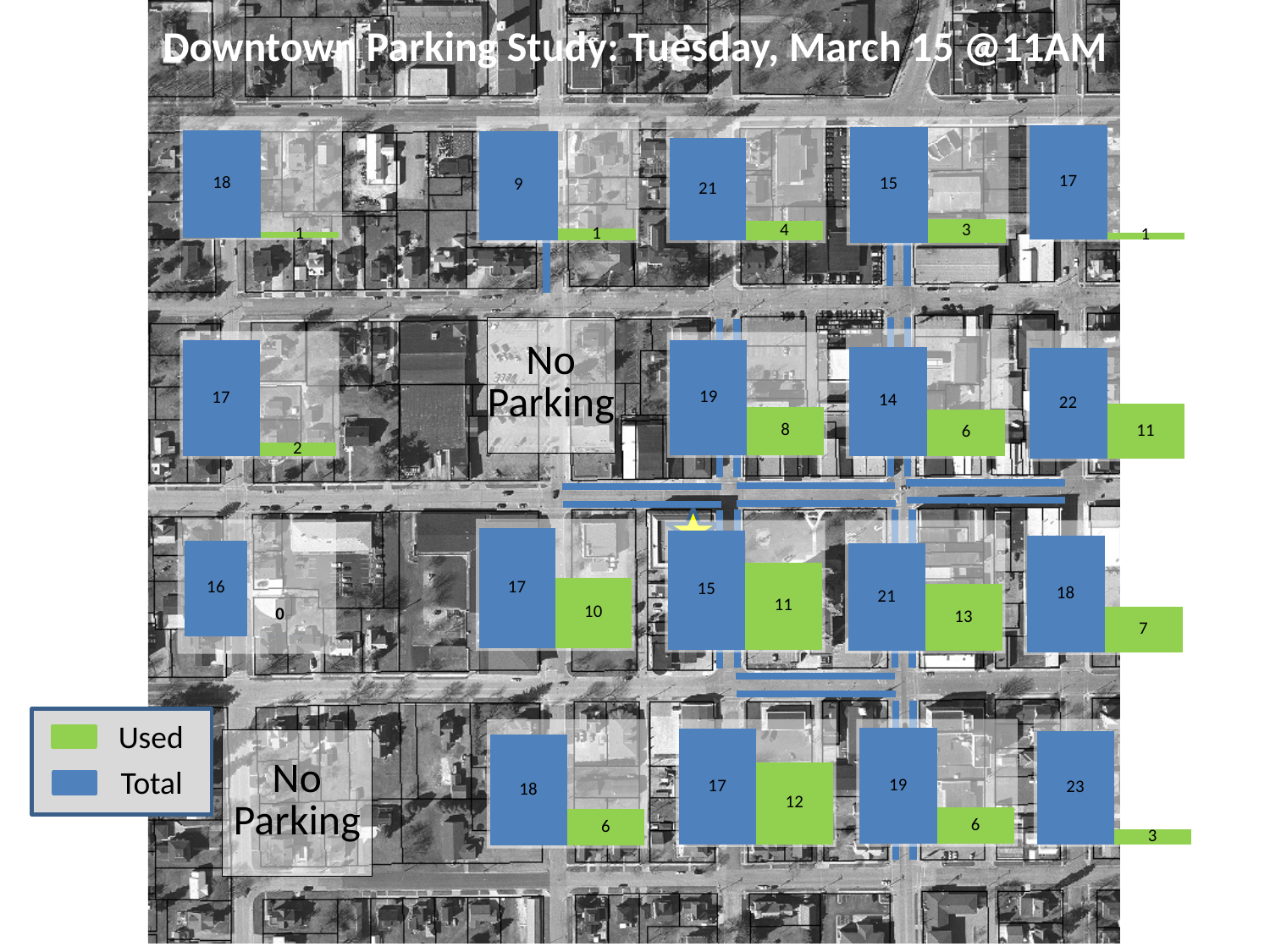
In the third row of blocks, the third chart from the left shows Total 15 and Used 11; which value is larger? Total Which colour represents the Used series in the legend? Green For the chart in the bottom-right corner of the map, what is the Total value? 23 How many series does the legend list? 2 Across all the block charts on the map, what is the highest Used value shown? 13 What is the title of the slide? Downtown Parking Study: Tuesday, March 15 @11AM For the chart in the bottom-right corner of the map, what is the Used value? 3 For the chart in the top-left corner of the map, what is the Total value? 18 Across all the block charts on the map, what is the highest Total value shown? 23 Across all the block charts on the map, what is the lowest Used value shown? 0 For the chart in the bottom-right corner of the map, what is the difference between the Total and Used values? 20 What kind of chart is used on each block of the map? Bar chart